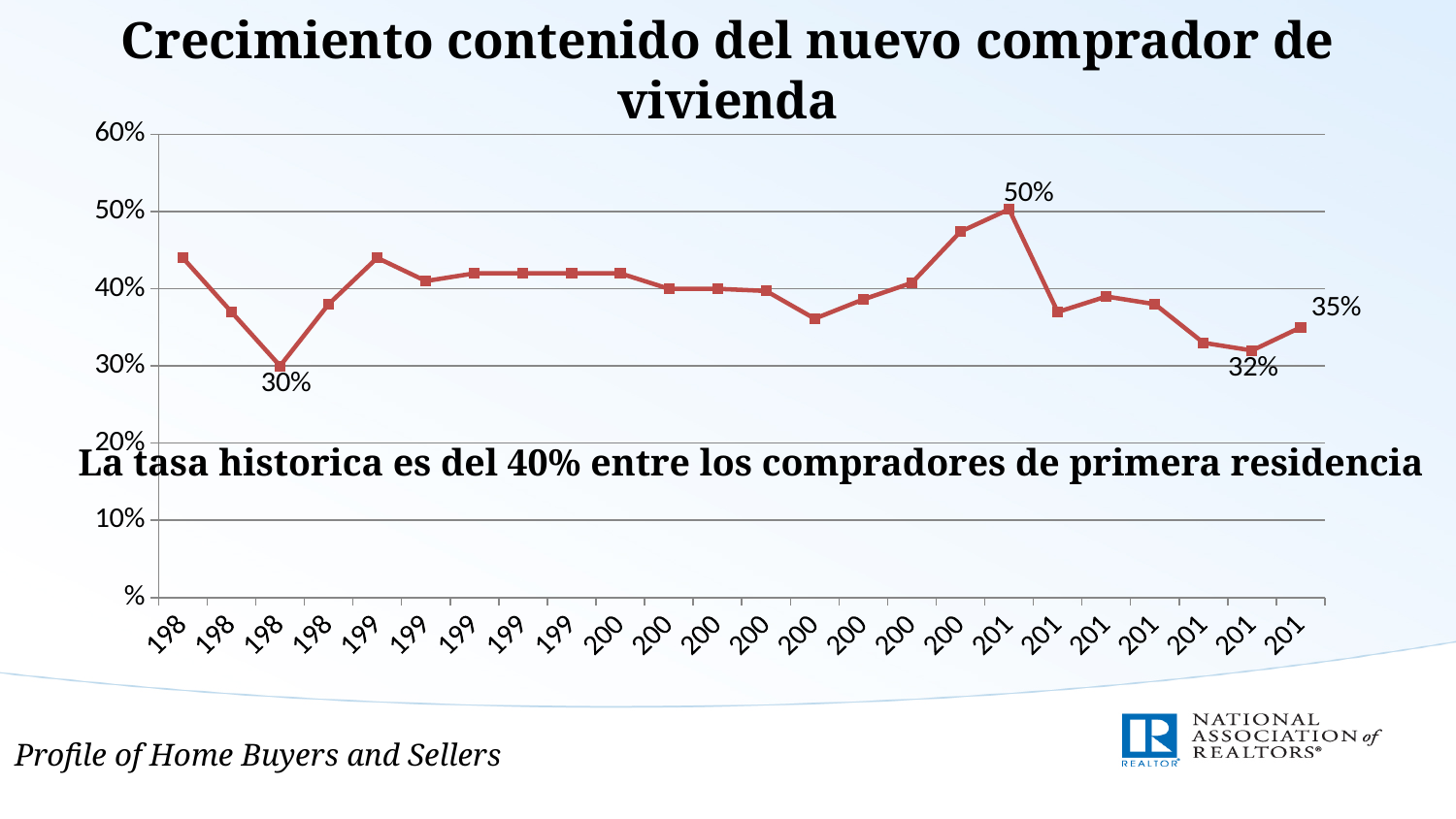
According to the text on the chart, what is the historical rate among first-time home buyers? 40% What is the value labeled at the last point on the right end of the line? 35% Is the value of the first point on the left of the line greater or less than 40%? greater What is the lowest value labeled on the line? 30% What is the highest value labeled on the line? 50% What kind of chart is shown on the slide? line chart Which is larger, the value labeled 50% or the value labeled 30%? 50% What is the difference between the highest labeled value (50%) and the lowest labeled value (30%)? 20 percentage points What is the difference between the final labeled value of 35% and the preceding labeled value of 32%? 3 percentage points What is the title of the chart? Crecimiento contenido del nuevo comprador de vivienda Does the line rise or fall immediately after the point labeled 50%? fall Is the value of the last point on the right of the line greater or less than 40%? less